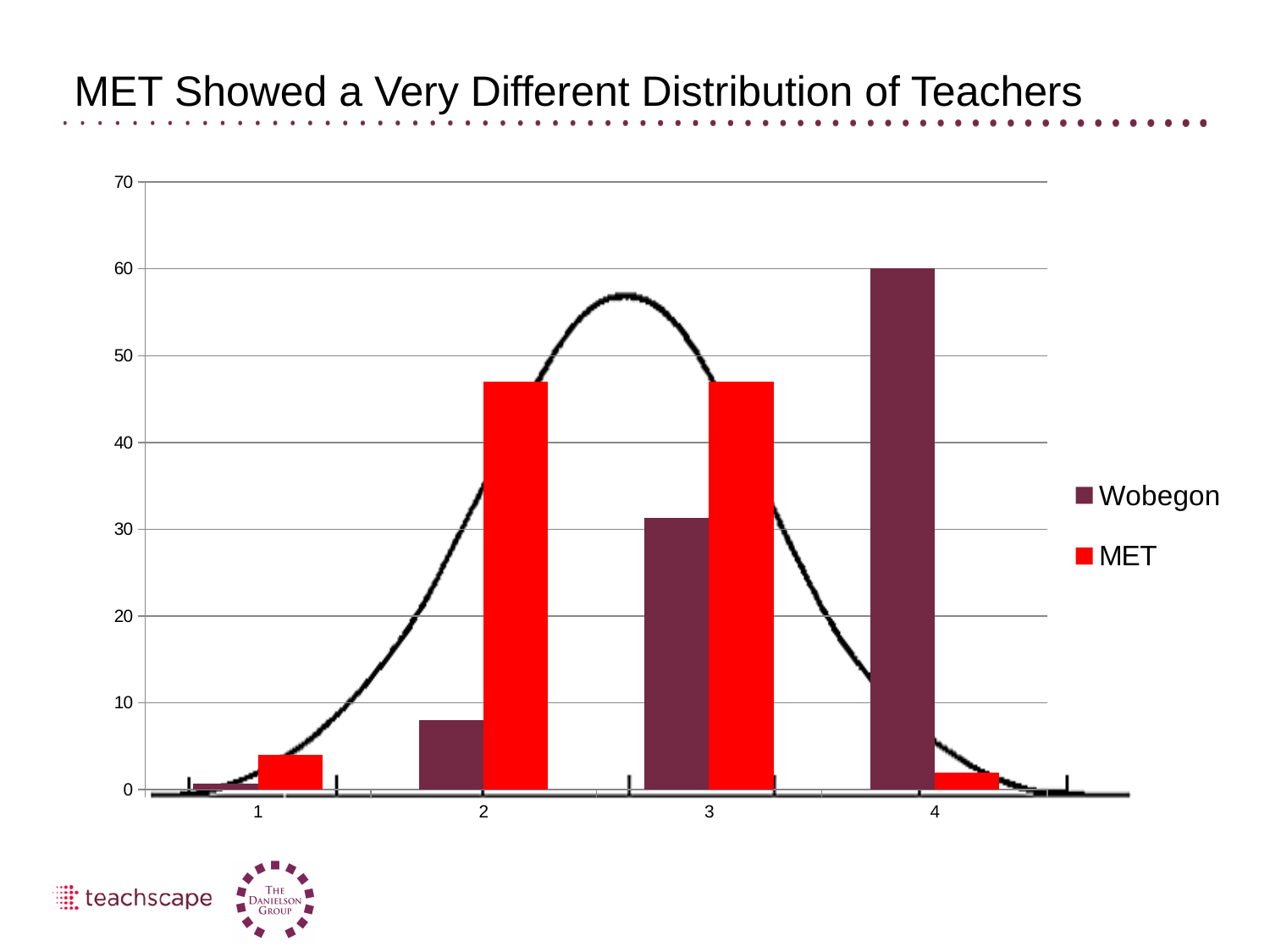
How many series does the legend list? 2 Which category has the highest value for Wobegon? 4 Which category has the lowest value for Wobegon? 1 At category 2, which series has the larger value, Wobegon or MET? MET How many categories are shown on the x axis? 4 What kind of chart is shown on the slide? bar chart At category 4, which series has the larger value, Wobegon or MET? Wobegon What colour are the MET bars? red Is the value for MET at category 4 greater or less than 10? less Is the value for MET at category 2 greater or less than 40? greater Is the value for Wobegon at category 2 greater or less than 10? less